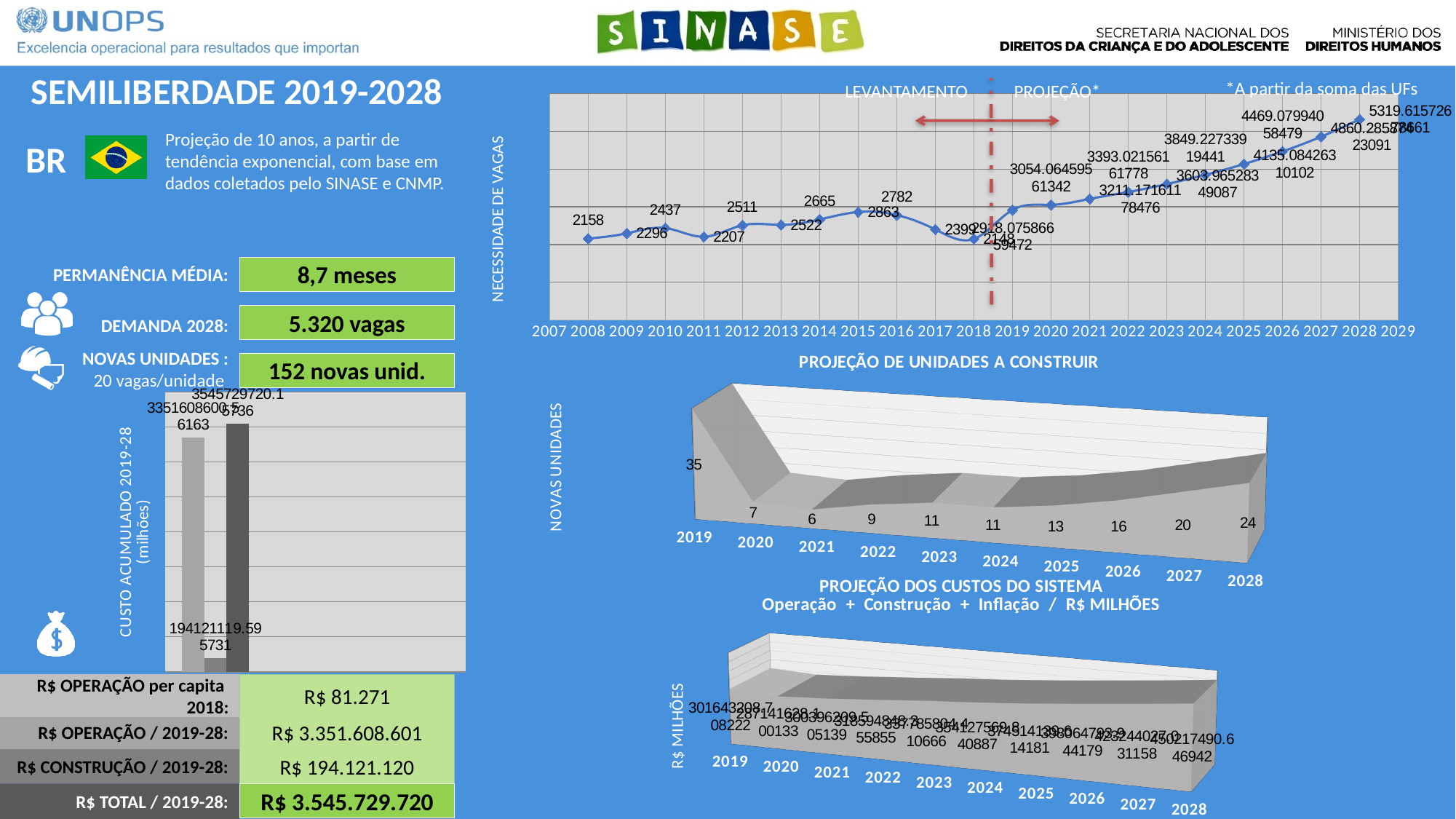
In the PROJEÇÃO DE UNIDADES A CONSTRUIR chart, which year has the highest value? 2019 In the PROJEÇÃO DE UNIDADES A CONSTRUIR chart, what is the difference between the 2028 value and the 2027 value? 4 In the NECESSIDADE DE VAGAS line chart, what is the value for 2008? 2158 In the PROJEÇÃO DE UNIDADES A CONSTRUIR chart, do the values rise or fall from 2021 to 2028? rise In the NECESSIDADE DE VAGAS line chart, what is the value for 2018? 2148 In the NECESSIDADE DE VAGAS line chart, what is the value for 2015? 2863 In the PROJEÇÃO DE UNIDADES A CONSTRUIR chart, which year has the lowest value? 2021 In the PROJEÇÃO DE UNIDADES A CONSTRUIR chart, what is the value for 2019? 35 In the NECESSIDADE DE VAGAS line chart, what is the difference between the 2015 value and the 2008 value? 705 What kind of chart is the top-right chart labelled NECESSIDADE DE VAGAS? line chart In the NECESSIDADE DE VAGAS line chart, which year has the larger value, 2010 or 2011? 2010 How many years are shown on the x axis of the PROJEÇÃO DE UNIDADES A CONSTRUIR chart? 10